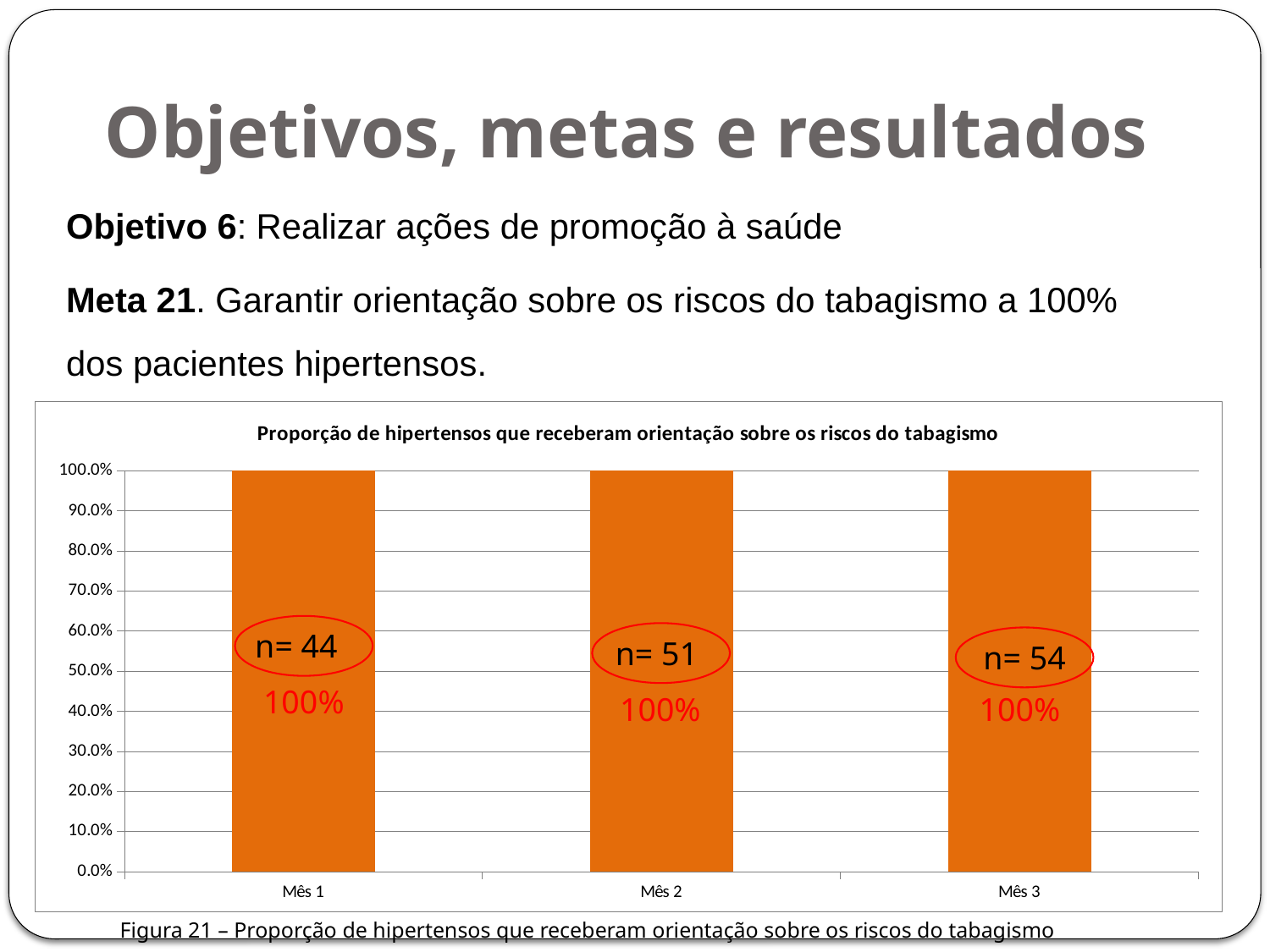
What is the value for Mês 1? 100% What is the value for Mês 2? 100% What is the n value shown for Mês 2? n= 51 What is the title of the chart? Proporção de hipertensos que receberam orientação sobre os riscos do tabagismo Do the values rise, fall or stay the same from Mês 1 to Mês 3? stay the same What is the value for Mês 3? 100% How many categories are shown on the x axis? 3 What kind of chart is this? bar chart Is the value for Mês 2 greater or less than 50.0%? greater What is the n value shown for Mês 3? n= 54 What is the n value shown for Mês 1? n= 44 What colour are the bars? orange